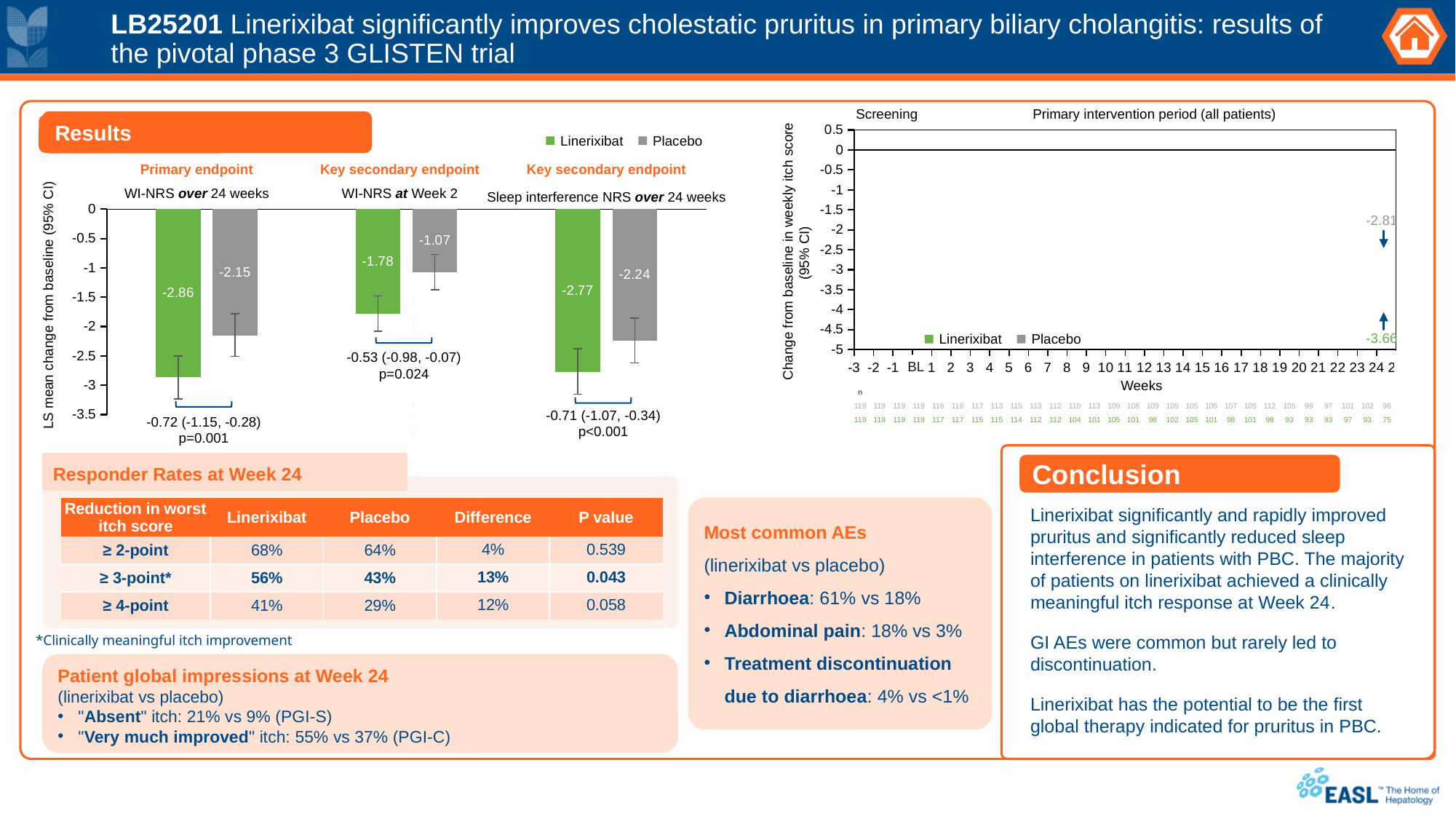
On the left bar chart, what is the LS mean change from baseline for Placebo for WI-NRS at Week 2? -1.07 On the left bar chart, how many series does the legend list? 2 On the left bar chart, what is the difference between the Linerixibat values for WI-NRS over 24 weeks (-2.86) and WI-NRS at Week 2 (-1.78)? 1.08 On the left bar chart, for Sleep interference NRS over 24 weeks, which series has the more negative value, Linerixibat or Placebo? Linerixibat On the right chart (Change from baseline in weekly itch score), what value is labelled for Linerixibat at Week 24? -3.66 On the left bar chart, how many endpoint categories are shown on the x axis? 3 On the left bar chart, what colour represents Linerixibat in the legend? green On the left bar chart, what is the LS mean change from baseline for Placebo for Sleep interference NRS over 24 weeks? -2.24 On the left bar chart, which bar shows the lowest (most negative) LS mean change from baseline? Linerixibat, WI-NRS over 24 weeks On the left bar chart, what is the LS mean change from baseline for Linerixibat for WI-NRS over 24 weeks? -2.86 On the right chart (Change from baseline in weekly itch score), what is the x-axis title? Weeks On the left bar chart (LS mean change from baseline), what kind of chart is it? bar chart